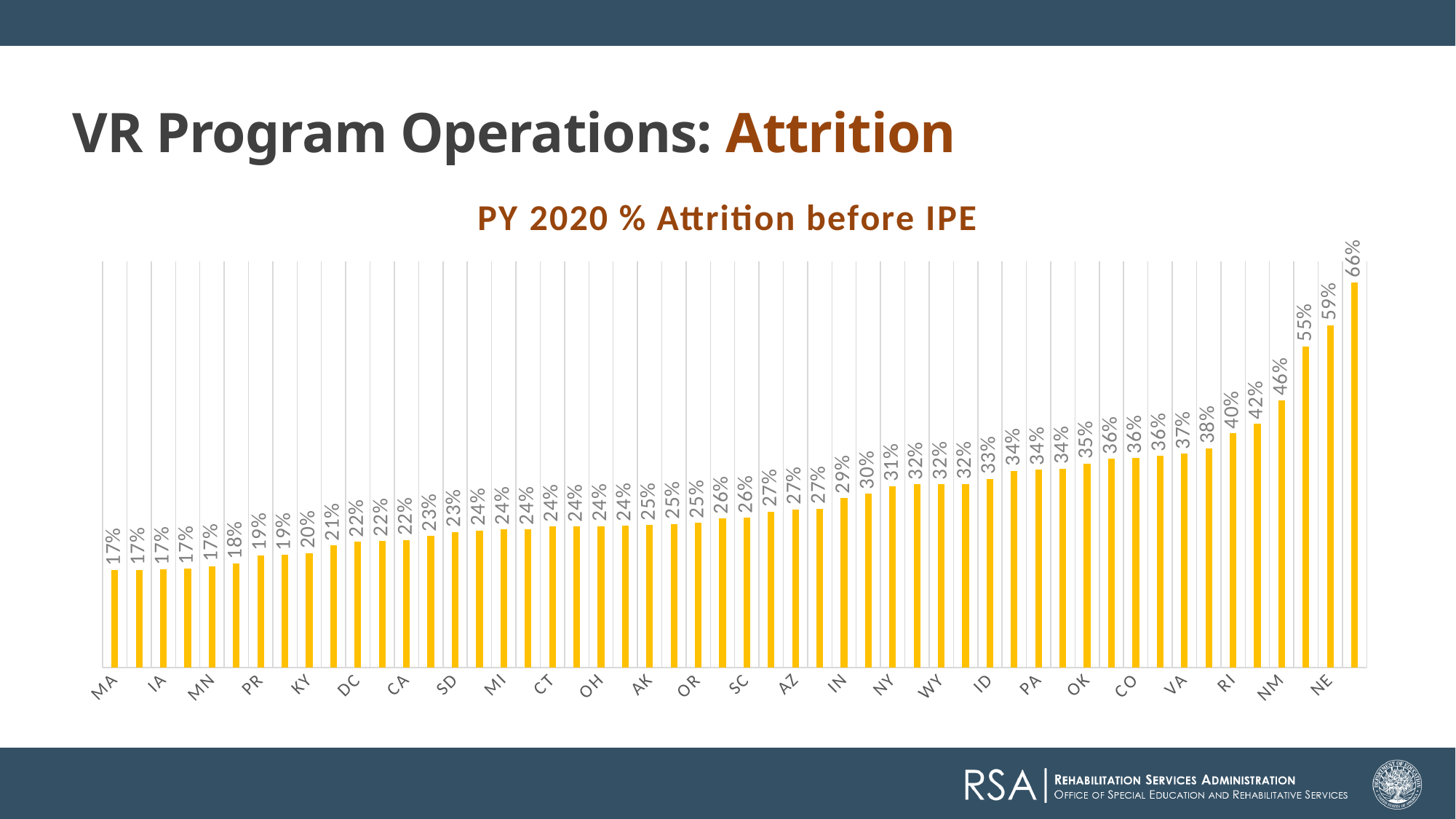
What is the highest attrition value shown in the chart? 66% What is the attrition value for MA? 17% How many data series are plotted in the chart? 1 What kind of chart is shown on the slide? Bar chart What colour are the bars in the chart? Yellow What is the title of the chart? PY 2020 % Attrition before IPE Do the values rise or fall moving from left to right along the x axis? Rise What is the lowest attrition value shown in the chart? 17% How many bars show a value of 17%? 5 Is the value for MA larger or smaller than the value of the rightmost bar? Smaller What is the difference between the highest and lowest attrition values shown? 49 percentage points How many bars are plotted in the chart? 52